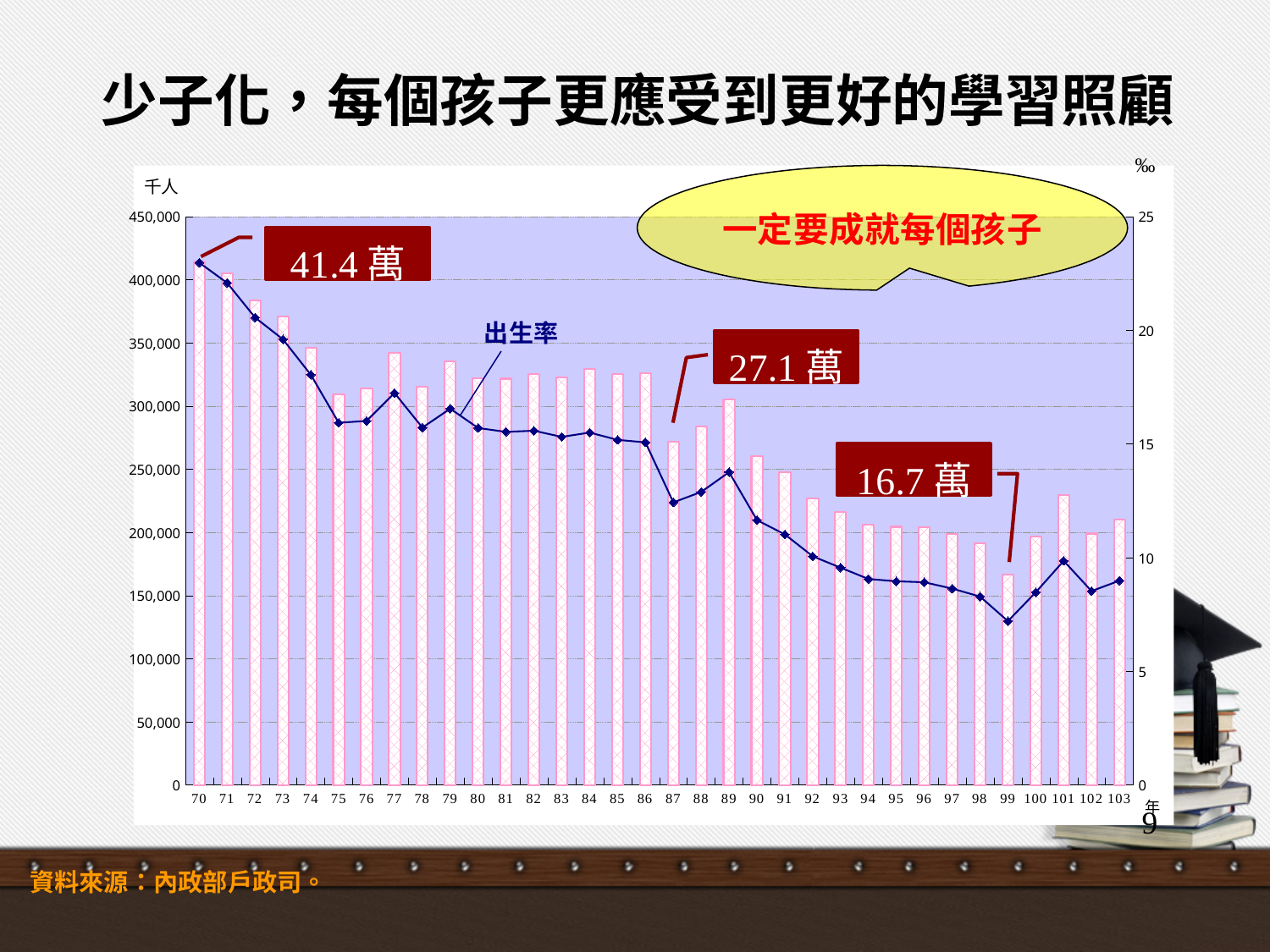
What is the label given to the line series on the chart? 出生率 Which year has the shortest bar? 99 Which year has the tallest bar? 70 Which bar is taller, year 89 or year 90? 89 How many years are shown on the x axis? 34 Is the line value (出生率) for year 99 greater or less than 10‰? less What value does the callout give for the bar at year 70? 41.4 萬 What kind of chart is shown on the slide? A combined bar and line chart Overall, do the bar values rise or fall from year 70 to year 103? fall What value does the callout give for the bar at year 99? 16.7 萬 Is the bar for year 70 greater or less than 400,000? greater What value does the callout give for the bar at year 87? 27.1 萬